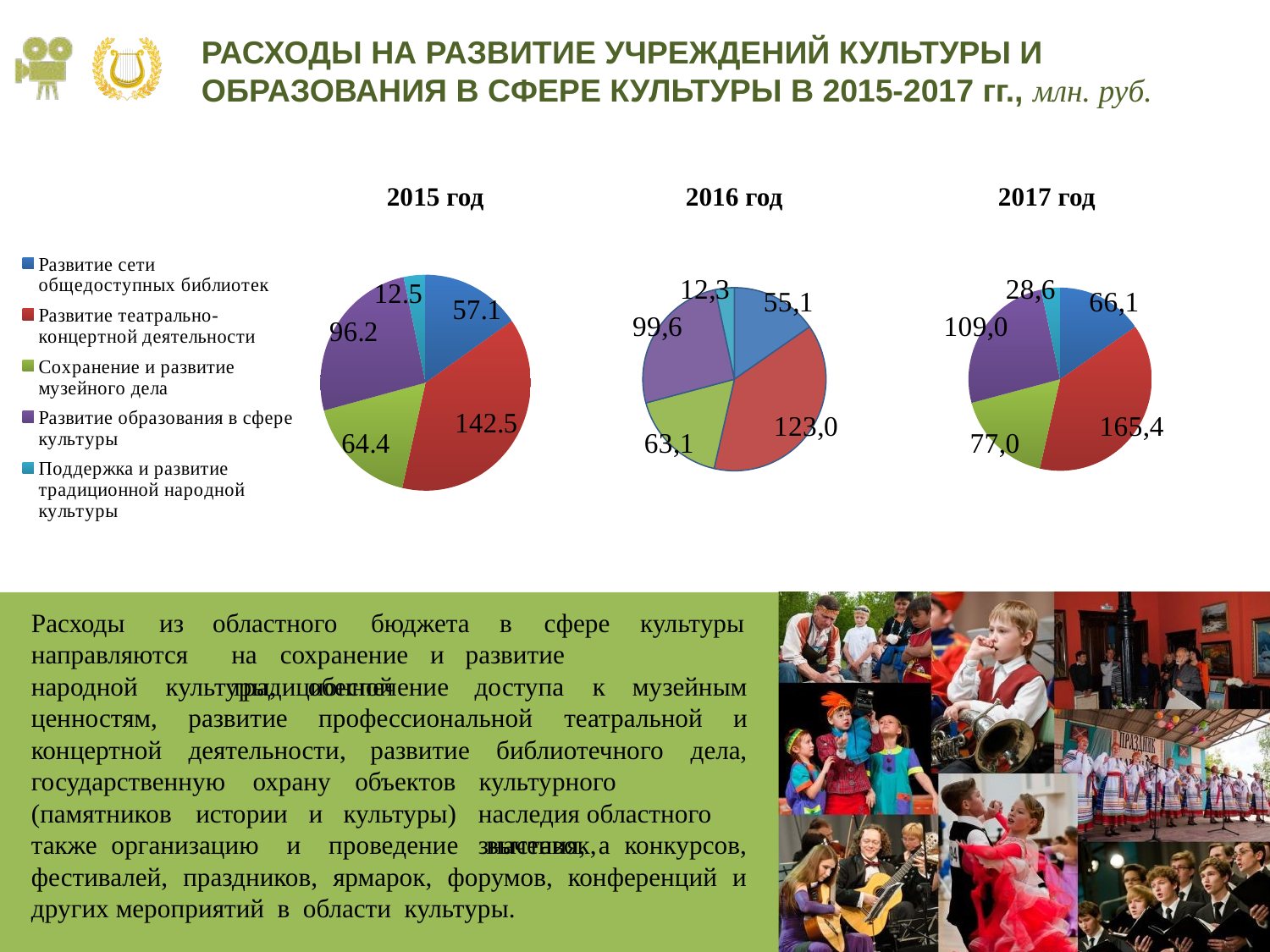
In the 2016 год pie chart, which category has the largest value? Развитие театрально-концертной деятельности How many pie charts are shown on the slide? 3 What kind of chart is used to show the 2016 год data? pie chart What is the total of all values in the 2015 год pie chart? 372.7 How many categories does the legend list for the pie charts? 5 In the 2017 год pie chart, what is the value for Развитие образования в сфере культуры? 109,0 In the 2017 год pie chart, what is the difference between the values for Развитие театрально-концертной деятельности and Сохранение и развитие музейного дела? 88,4 In the 2015 год pie chart, what is the value for Развитие театрально-концертной деятельности? 142.5 In the 2017 год pie chart, which category has the smallest value? Поддержка и развитие традиционной народной культуры Which colour represents Развитие сети общедоступных библиотек in the pie charts? blue In the 2015 год pie chart, which is larger: the value for Развитие образования в сфере культуры or the value for Сохранение и развитие музейного дела? Развитие образования в сфере культуры In the 2016 год pie chart, what is the value for Поддержка и развитие традиционной народной культуры? 12,3